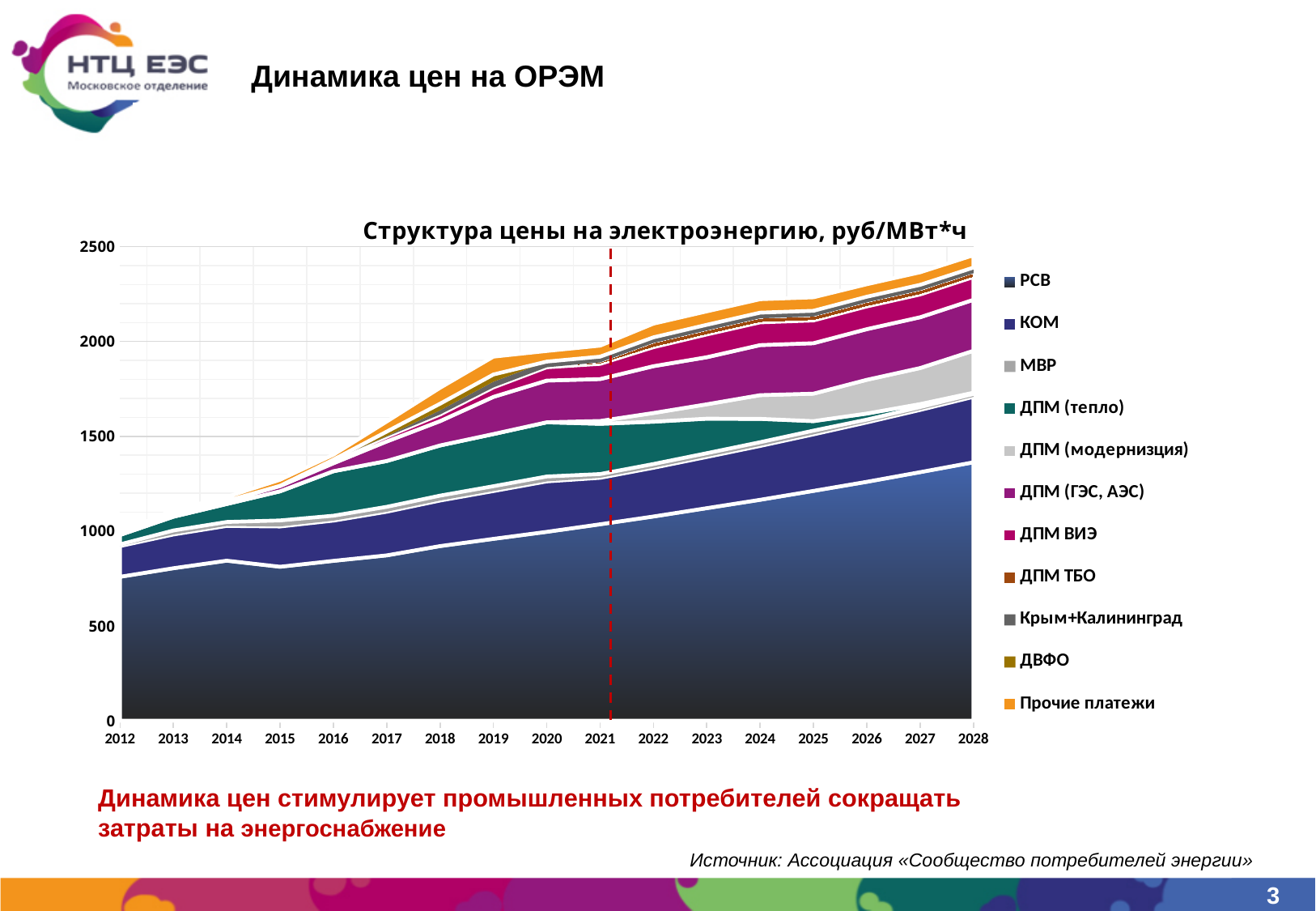
How many years are shown along the x axis? 17 Is the total price in 2016 greater or less than 1500? less Does the total electricity price rise or fall from 2012 to 2028? rises Is the total price in 2028 greater or less than 2000? greater Which year has the lowest total price? 2012 How many series does the legend list? 11 Is the value for РСВ in 2012 greater or less than 1000? less Which year has the highest total price? 2028 Which series is listed last in the legend? Прочие платежи What kind of chart is shown on the slide? stacked area chart What is the title of the chart? Структура цены на электроэнергию, руб/МВт*ч